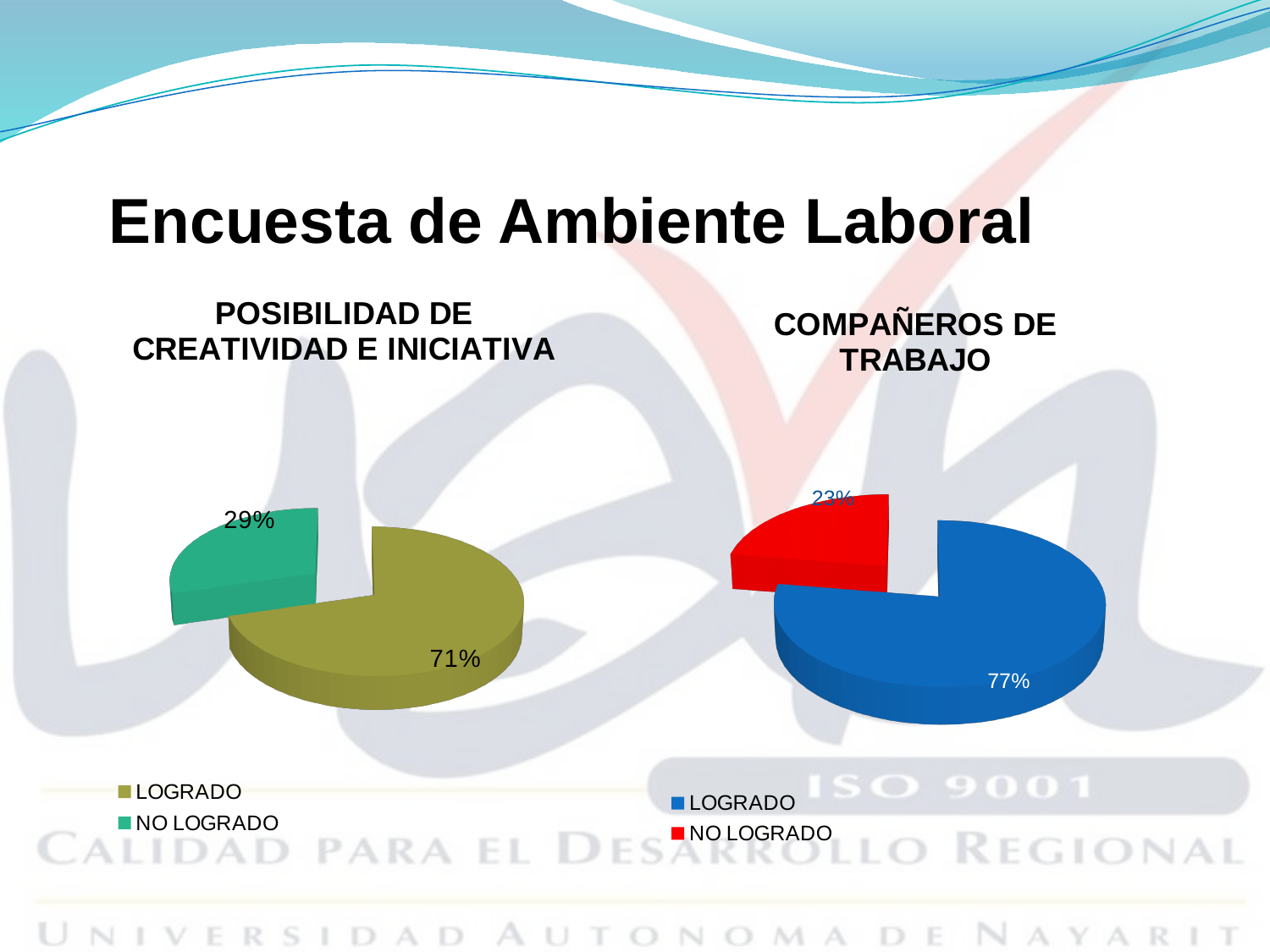
What kind of chart is the 'COMPAÑEROS DE TRABAJO' chart? Pie chart In the 'POSIBILIDAD DE CREATIVIDAD E INICIATIVA' chart, which slice is the largest? LOGRADO Which chart has the larger LOGRADO share, 'POSIBILIDAD DE CREATIVIDAD E INICIATIVA' or 'COMPAÑEROS DE TRABAJO'? COMPAÑEROS DE TRABAJO In the 'POSIBILIDAD DE CREATIVIDAD E INICIATIVA' chart, what share is NO LOGRADO? 29% In the 'COMPAÑEROS DE TRABAJO' chart, what is the difference between the LOGRADO and NO LOGRADO shares? 54% In the 'COMPAÑEROS DE TRABAJO' chart, which slice is the smallest? NO LOGRADO In the 'POSIBILIDAD DE CREATIVIDAD E INICIATIVA' chart, what share is LOGRADO? 71% How many slices does the 'POSIBILIDAD DE CREATIVIDAD E INICIATIVA' chart have? 2 In the 'COMPAÑEROS DE TRABAJO' chart, what colour is the NO LOGRADO slice? Red In the 'COMPAÑEROS DE TRABAJO' chart, what share is NO LOGRADO? 23% In the 'POSIBILIDAD DE CREATIVIDAD E INICIATIVA' chart, what is the difference between the LOGRADO and NO LOGRADO shares? 42%